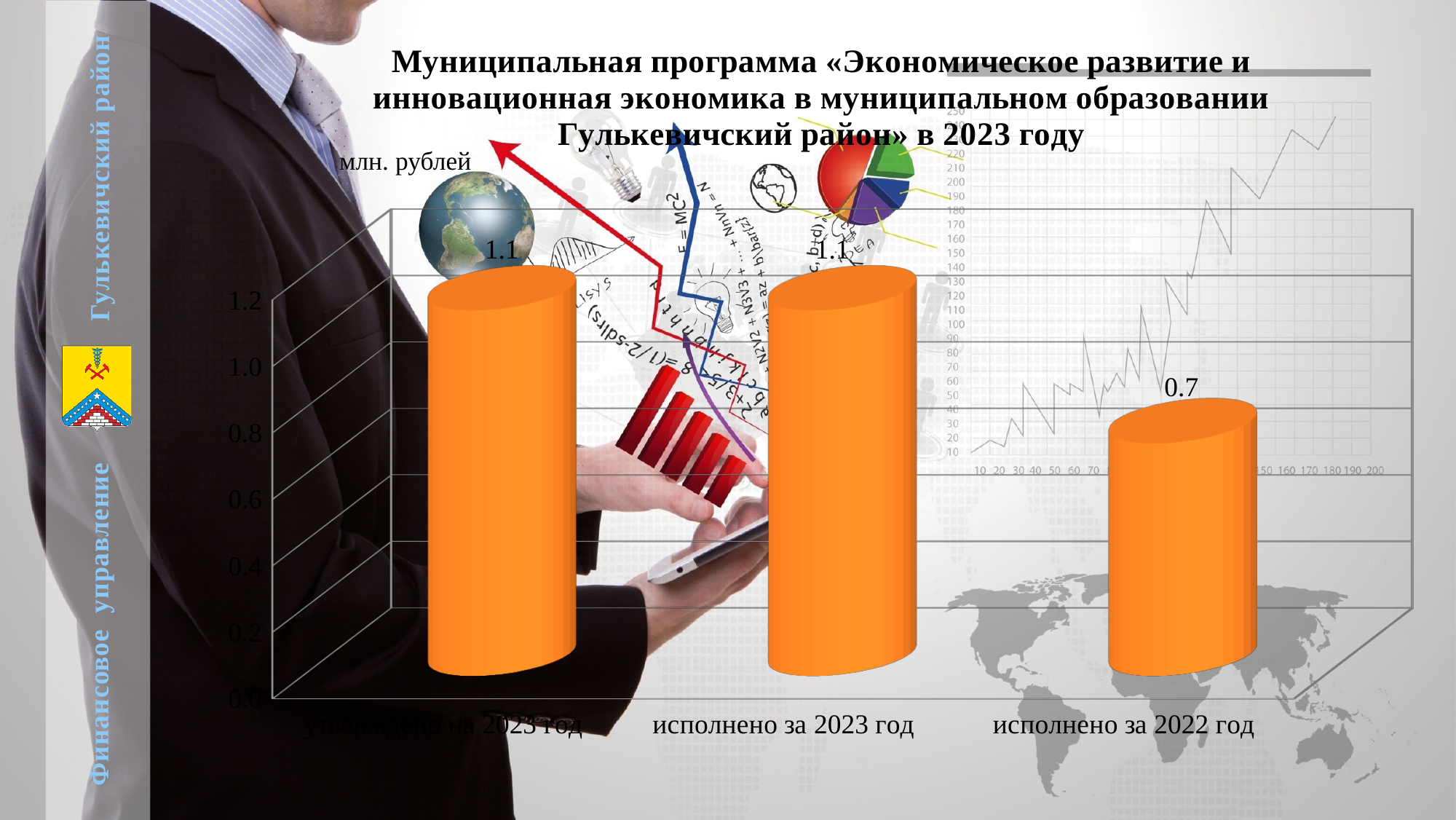
How many categories are shown on the chart? 3 What unit of measurement is indicated for the chart values? млн. рублей What is the value for «исполнено за 2022 год»? 0.7 Is the value for «исполнено за 2023 год» greater or less than 1.0? greater What is the value for «утверждено на 2023 год»? 1.1 Which is larger: the value for «утверждено на 2023 год» or the value for «исполнено за 2022 год»? утверждено на 2023 год What kind of chart is shown on the slide? bar chart What is the difference between the value for «исполнено за 2023 год» and the value for «исполнено за 2022 год»? 0.4 Which category has the lowest value? исполнено за 2022 год Is the value for «исполнено за 2022 год» greater or less than 1.0? less What is the value for «исполнено за 2023 год»? 1.1 What is the highest tick value shown on the vertical axis? 1.2